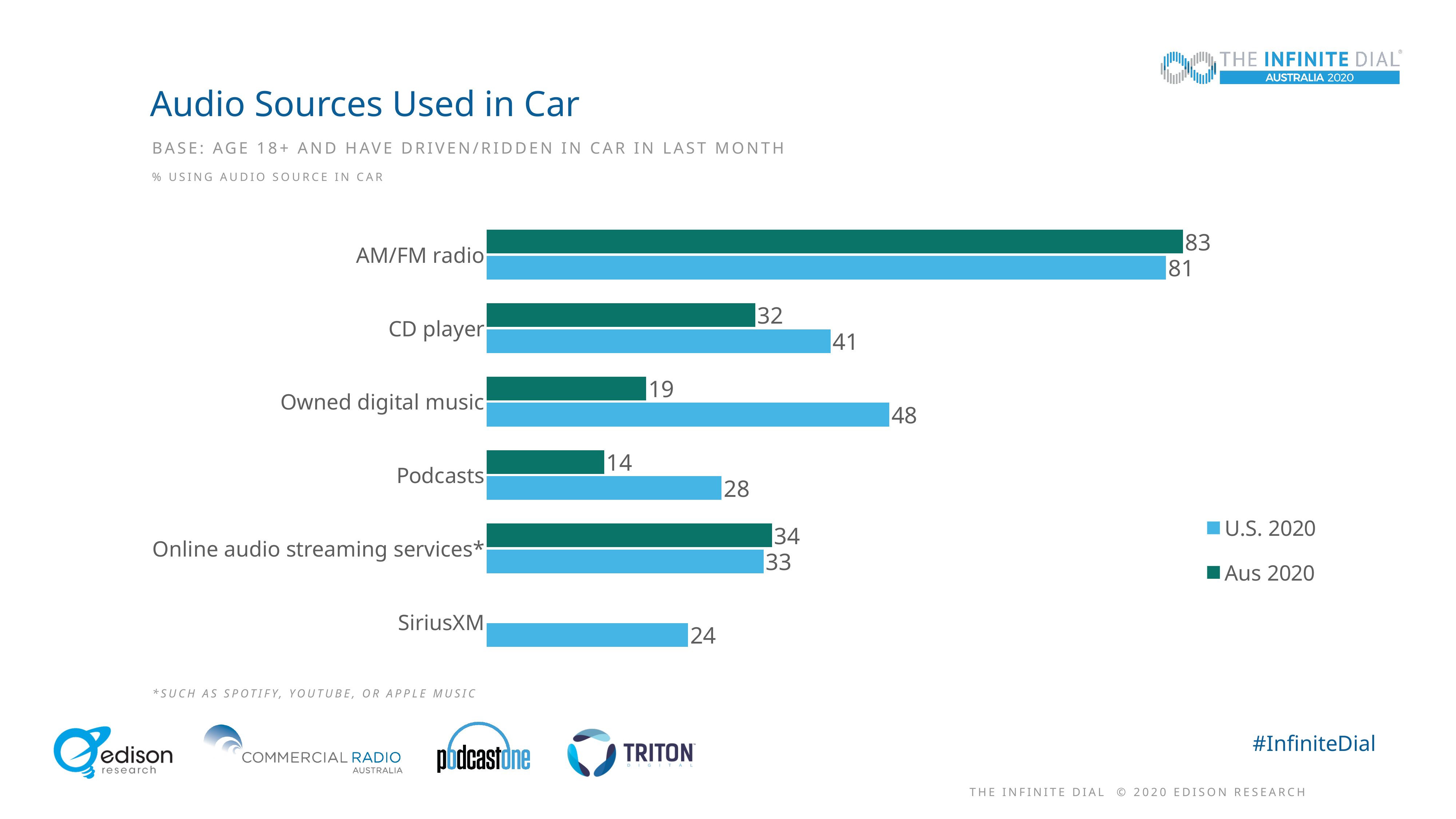
What is the U.S. 2020 value for SiriusXM? 24 What is the Aus 2020 value for Podcasts? 14 What kind of chart is shown on the slide? Bar chart What is the difference between the U.S. 2020 and Aus 2020 values for Owned digital music? 29 Which category has the lowest U.S. 2020 value? SiriusXM How many series does the legend list? 2 How many categories are shown on the chart? 6 Which category has the highest Aus 2020 value? AM/FM radio What is the Aus 2020 value for AM/FM radio? 83 What is the U.S. 2020 value for Owned digital music? 48 What is the title of the chart? Audio Sources Used in Car Which is larger for CD player: the U.S. 2020 value or the Aus 2020 value? U.S. 2020